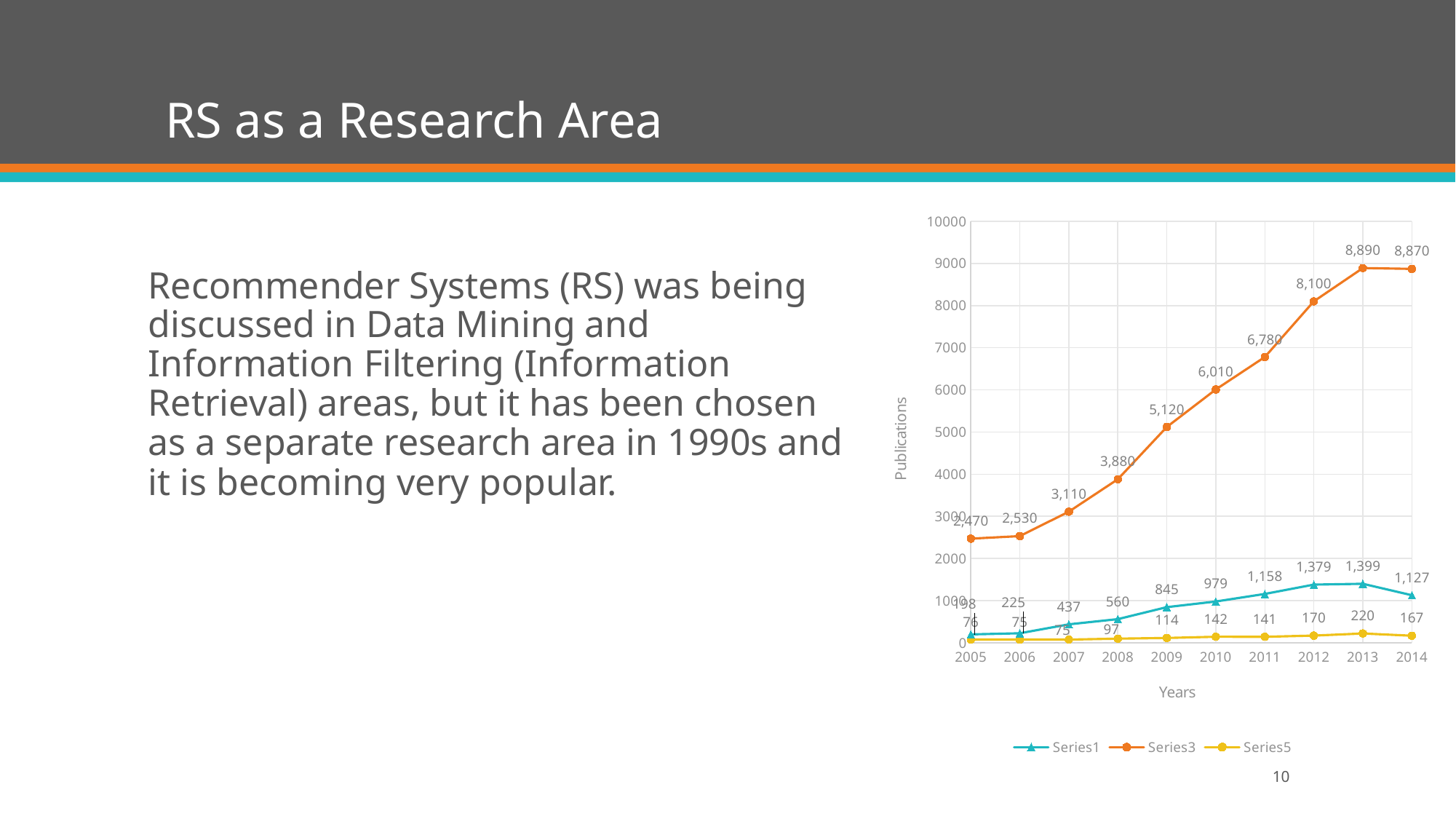
How many years are plotted along the x axis? 10 In which year is Series1 at its lowest value? 2005 Is the Series3 value for 2009 greater or less than 5000? greater Which is larger, the Series1 value in 2012 or in 2014? 2012 In which year does Series3 reach its highest value? 2013 What is the label of the y axis? Publications What is the value of Series1 in 2011? 1,158 What is the difference between the Series3 values for 2012 and 2011? 1,320 What is the value of Series5 in 2013? 220 What is the value of Series3 in 2013? 8,890 How many series does the legend list? 3 What kind of chart is shown on the slide? line chart